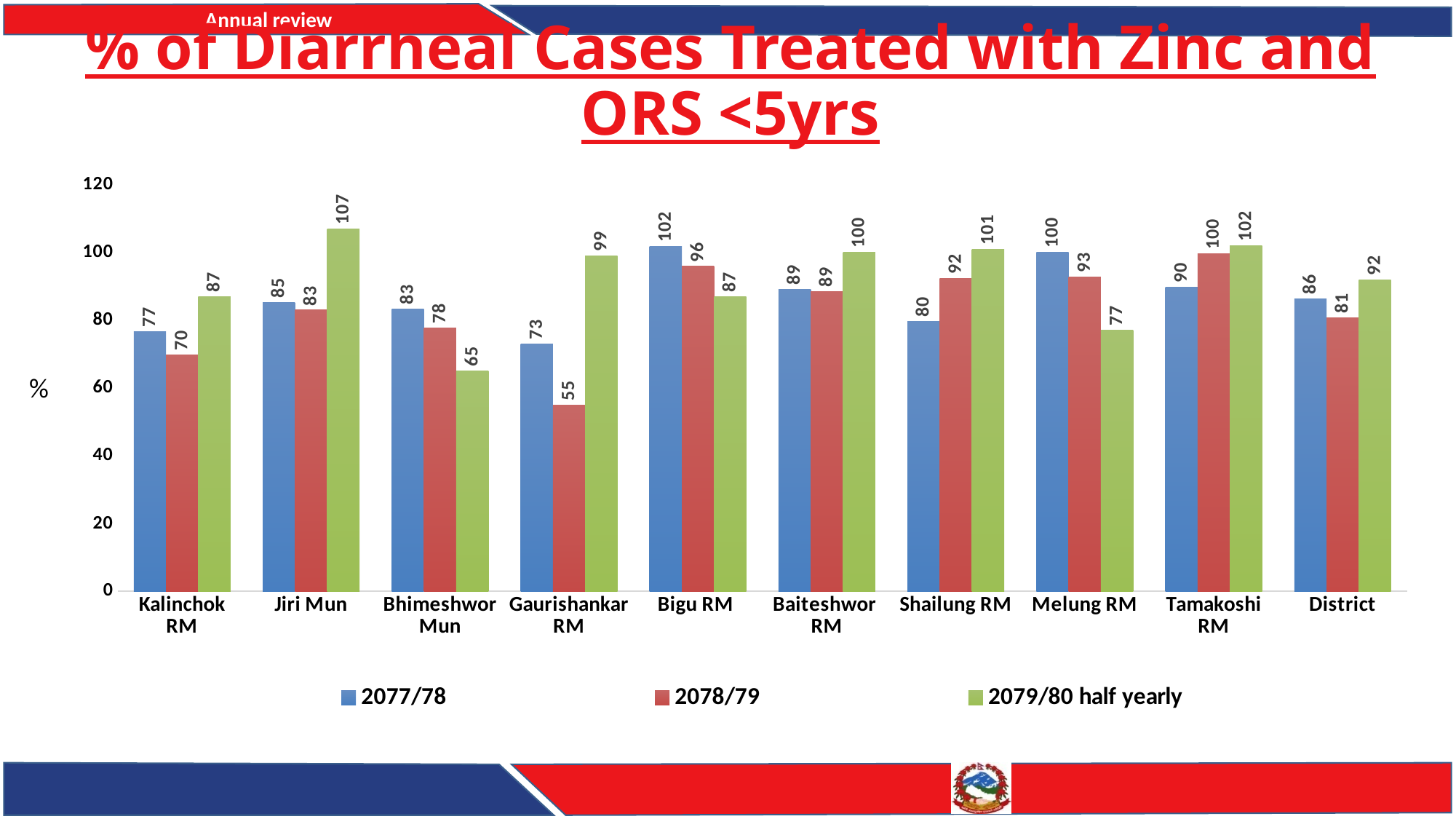
What is the title of the chart? % of Diarrheal Cases Treated with Zinc and ORS <5yrs Which category has the lowest value in the 2078/79 series? Gaurishankar RM What kind of chart is shown on the slide? bar chart Which is larger for Melung RM: the 2077/78 value or the 2079/80 half yearly value? 2077/78 What is the value for District in the 2077/78 series? 86 What is the value for Jiri Mun in the 2079/80 half yearly series? 107 Which category has the highest value in the 2079/80 half yearly series? Jiri Mun Is the value for Bhimeshwor Mun in the 2079/80 half yearly series greater or less than 80? less What is the difference between the 2079/80 half yearly and 2077/78 values for Gaurishankar RM? 26 What is the value for Gaurishankar RM in the 2078/79 series? 55 How many series does the legend list? 3 How many categories are shown on the x axis? 10